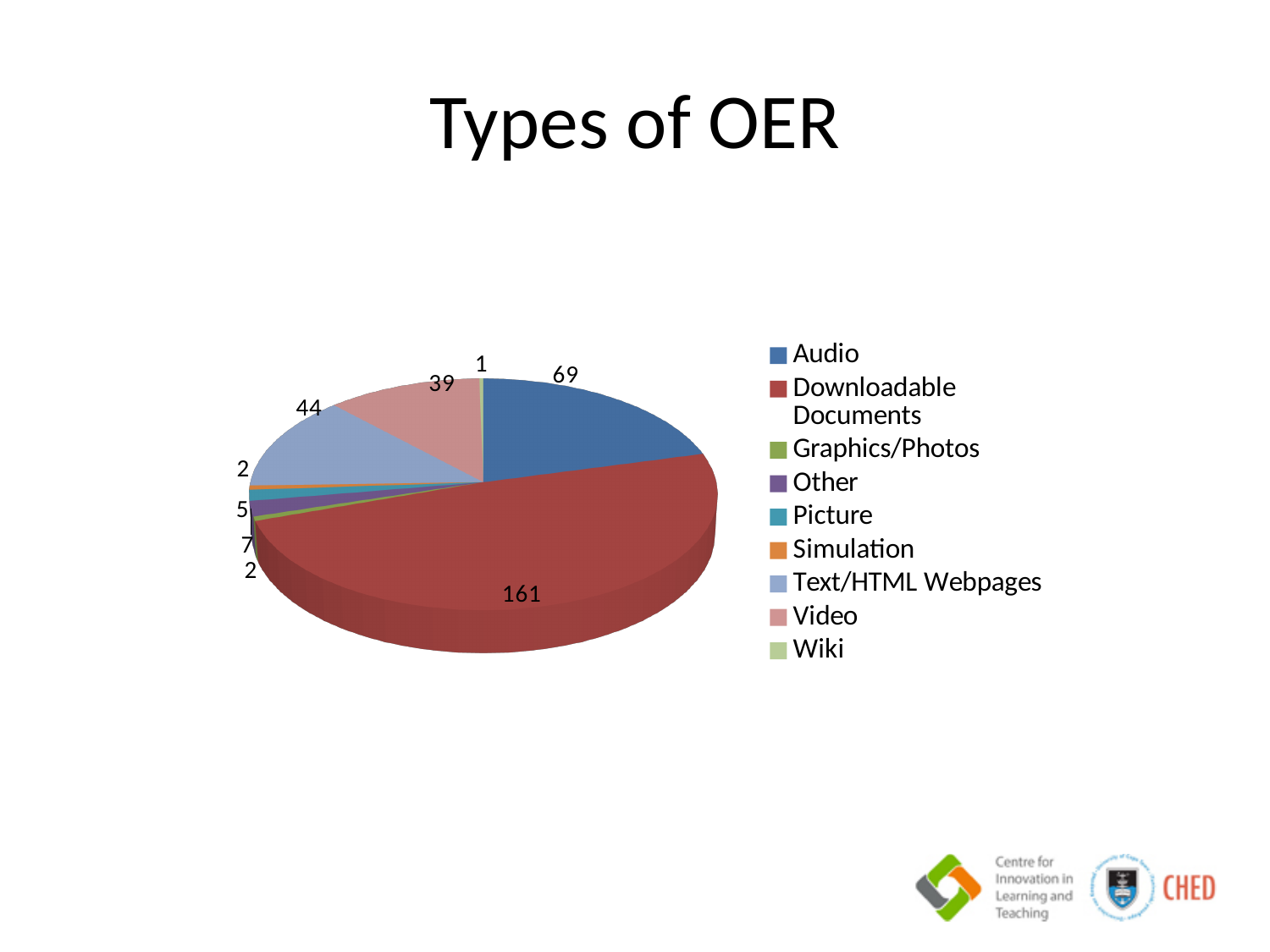
How many categories does the legend list? 9 Which category has the smallest slice? Wiki What type of chart is shown on the slide? pie chart What is the difference between the values for Downloadable Documents and Audio? 92 What is the value for Audio? 69 What is the value for Video? 39 What is the value for Downloadable Documents? 161 What is the value for Text/HTML Webpages? 44 Which is larger, the value for Text/HTML Webpages or the value for Video? Text/HTML Webpages What is the value for Wiki? 1 What is the title of the chart? Types of OER Which category has the largest slice? Downloadable Documents